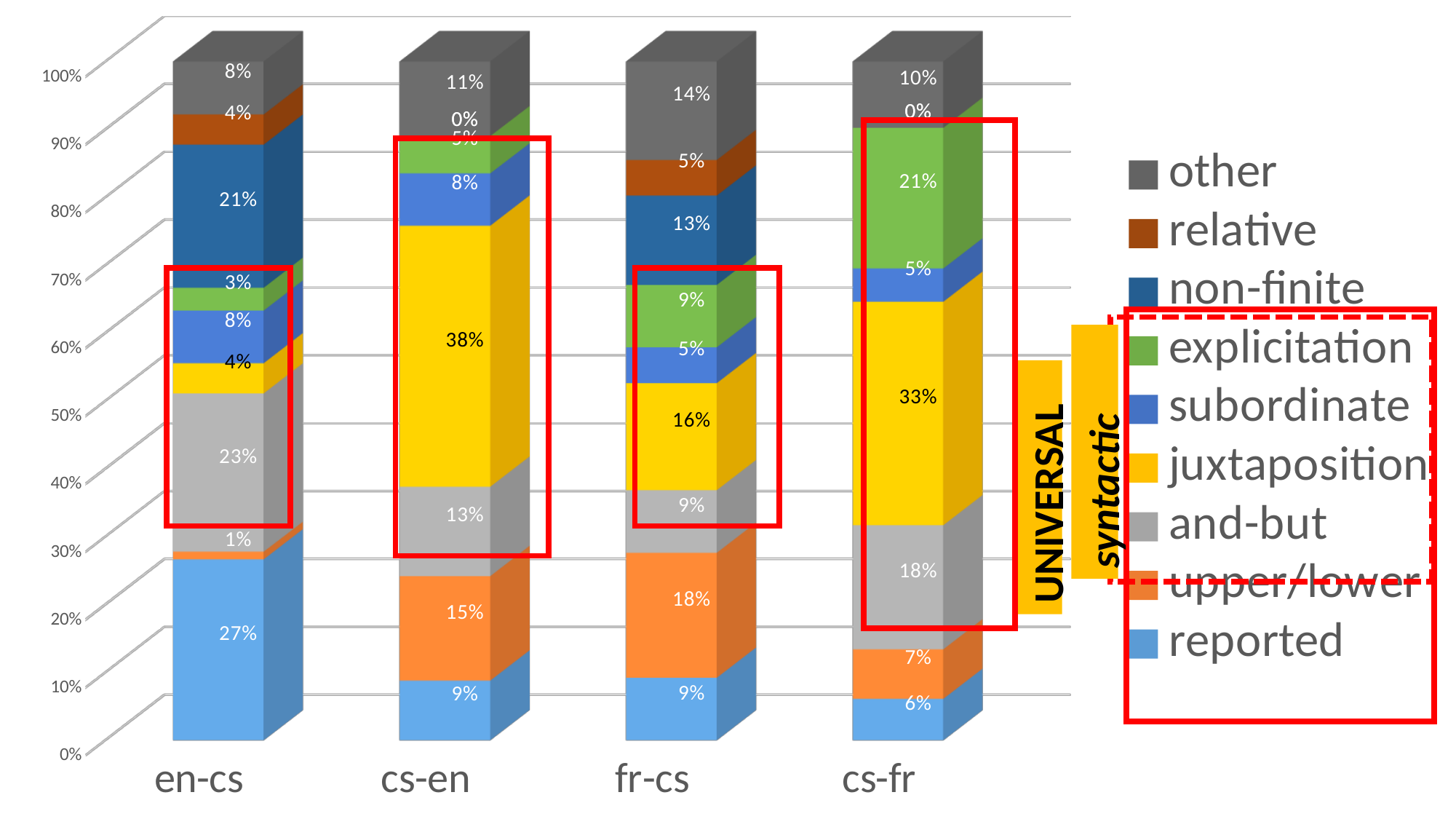
Which language pair has the lowest reported share? cs-fr What is the explicitation share for cs-fr? 21% What is the juxtaposition share for cs-en? 38% Which language pair has the highest juxtaposition share? cs-en What kind of chart is shown on the slide? Stacked bar chart Which is larger, the and-but share for en-cs or for cs-fr? en-cs What is the 'other' share for fr-cs? 14% How many language-pair categories are shown on the x axis? 4 What is the non-finite share for fr-cs? 13% What is the difference between the upper/lower share for fr-cs and for cs-en? 3 percentage points What is the reported share for en-cs? 27% How many series does the legend list? 9